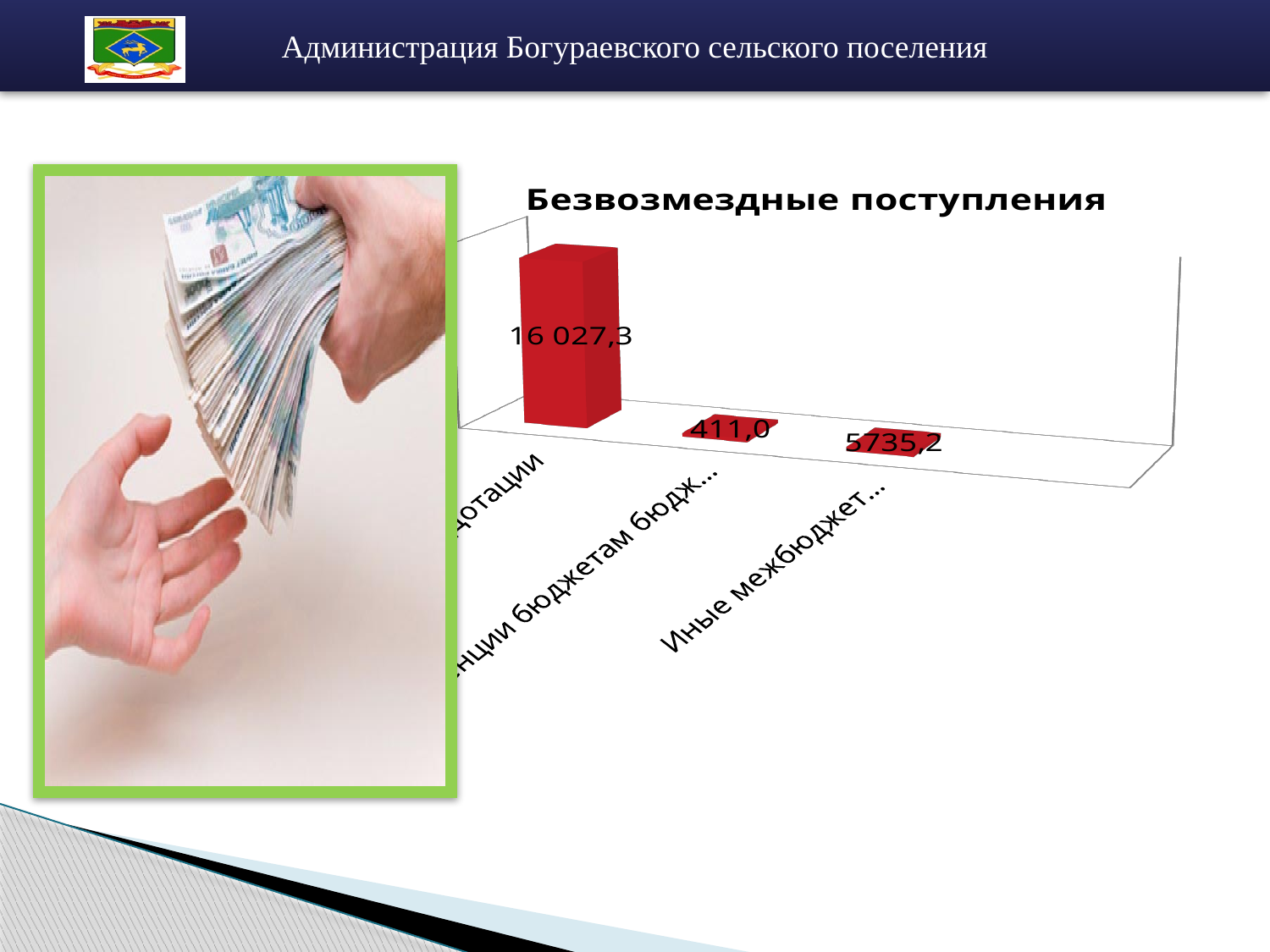
Which is larger: the middle bar or the bar labelled "Иные межбюджет..."? Иные межбюджет... (5735,2) What is the value shown on the middle bar of the chart? 411,0 What is the difference between the leftmost bar (16 027,3) and the bar labelled "Иные межбюджет..." (5735,2)? 10 292,1 Which bar has the lowest value? the middle bar (411,0) What colour are the bars in the chart? red What is the difference between the value for "Иные межбюджет..." and the middle bar's value? 5324,2 What is the title of the chart? Безвозмездные поступления How many bars does the chart show? 3 What is the value shown for the category labelled "Иные межбюджет..."? 5735,2 What is the value shown on the leftmost (tallest) bar of the chart? 16 027,3 Which bar has the highest value? the leftmost bar (16 027,3) What kind of chart is shown on the slide? bar chart